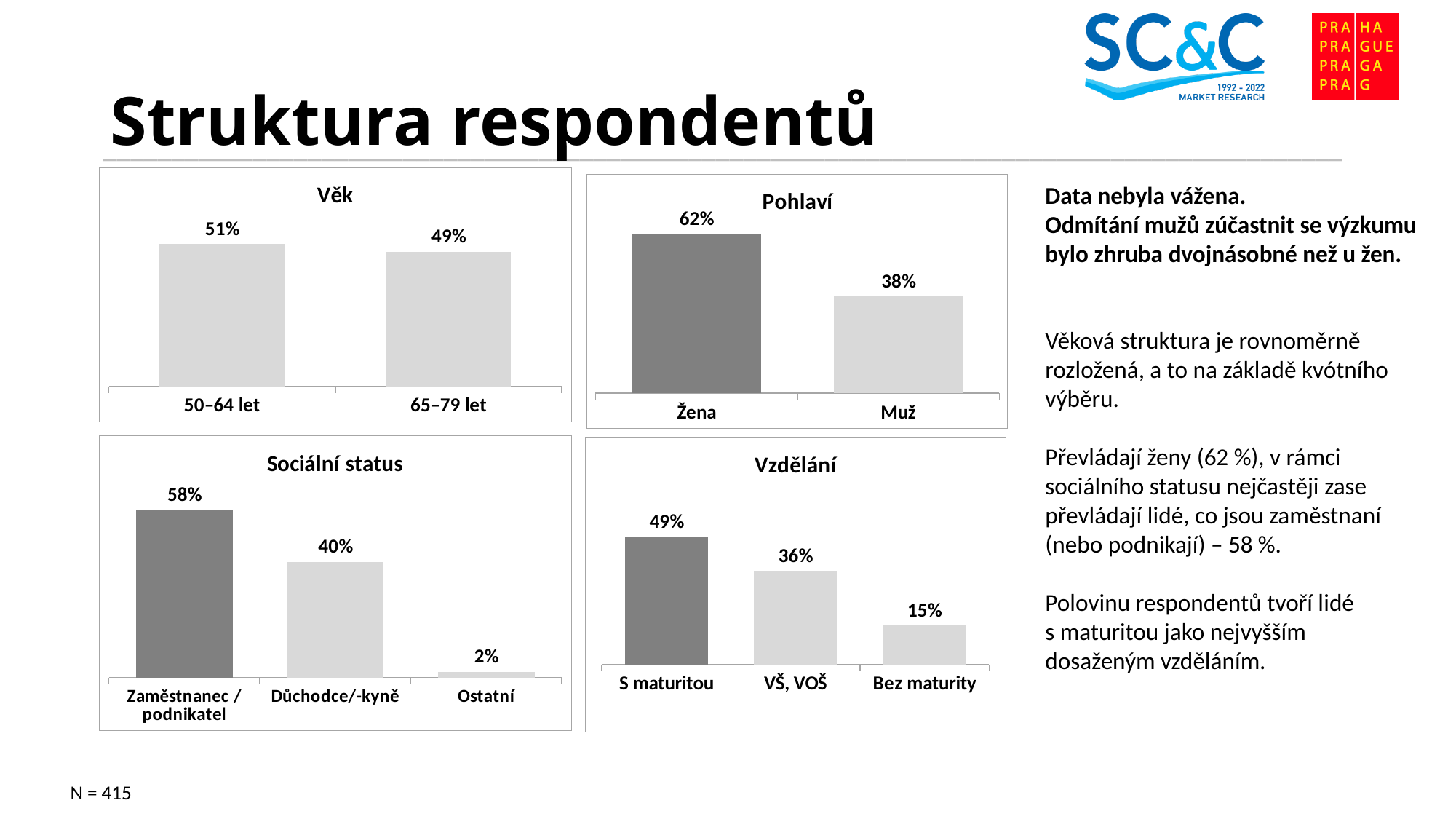
How many categories does the "Sociální status" chart show? 3 In the "Věk" chart, which is larger: 50–64 let or 65–79 let? 50–64 let In the "Pohlaví" chart, what is the difference between Žena and Muž? 24% In the "Vzdělání" chart, what is the difference between S maturitou and VŠ, VOŠ? 13% In the "Vzdělání" chart, which category has the lowest value? Bez maturity In the "Pohlaví" chart, what is the value for Muž? 38% In the "Věk" chart, what is the value for 50–64 let? 51% In the "Sociální status" chart, which category has the highest value? Zaměstnanec / podnikatel What kind of chart is the "Pohlaví" chart? Bar chart In the "Vzdělání" chart, do the values rise or fall from left to right? Fall In the "Sociální status" chart, what is the value for Důchodce/-kyně? 40% In the "Vzdělání" chart, what is the value for Bez maturity? 15%